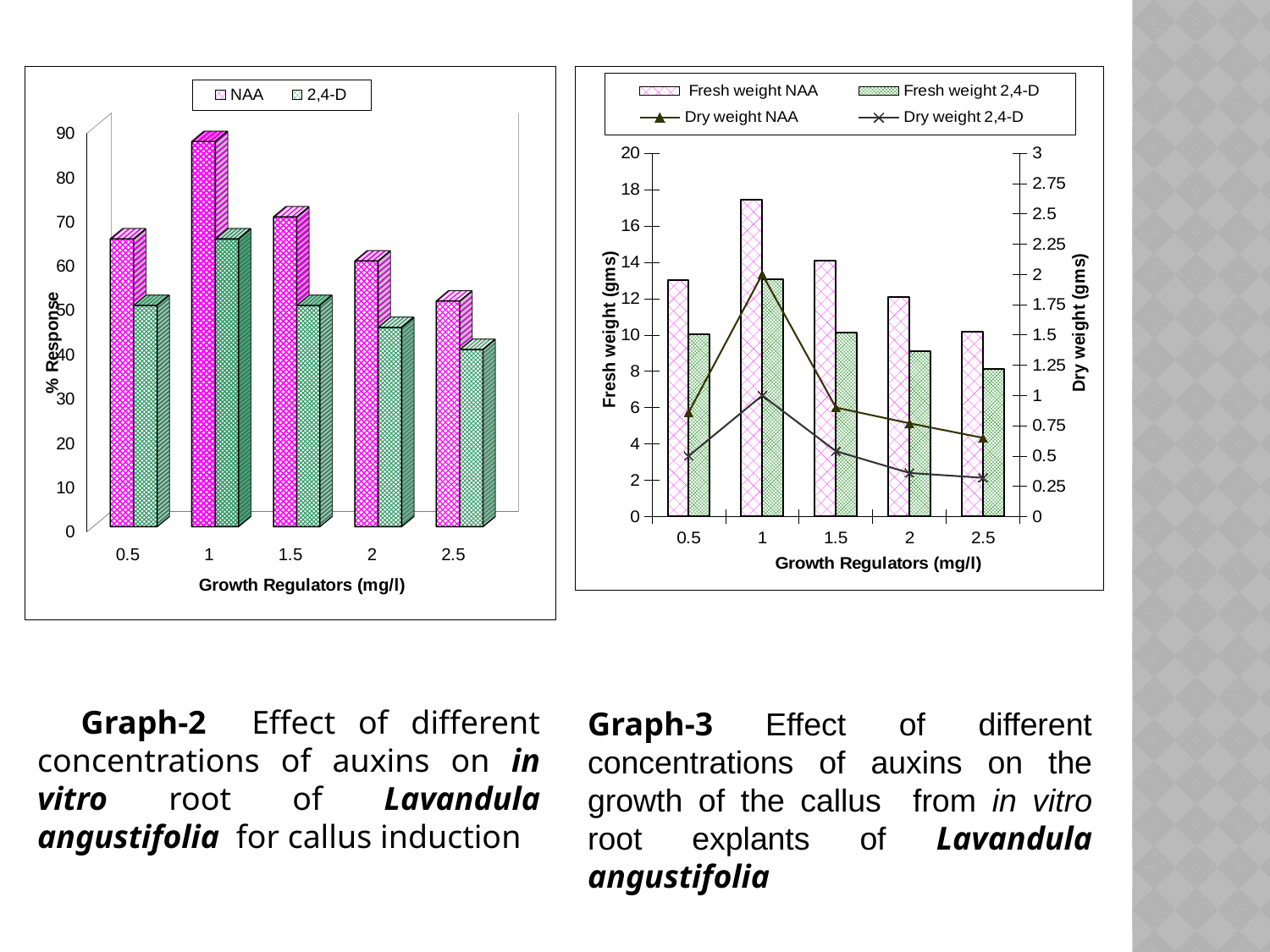
How many series does the legend of Graph-3 (right chart) list? 4 In Graph-2 (left chart), at which concentration is the 2,4-D bar lowest? 2.5 How many growth regulator concentrations are shown on the x axis of Graph-2 (left chart)? 5 What kind of chart is Graph-2 (left chart)? bar chart In Graph-2 (left chart), is the % Response for NAA at 1 mg/l greater or less than 80? greater In Graph-3 (right chart), at which concentration is the Fresh weight NAA bar highest? 1 In Graph-2 (left chart), at which growth regulator concentration is the NAA bar highest? 1 In Graph-3 (right chart), is the Fresh weight NAA value at 1 mg/l greater or less than 16? greater In Graph-2 (left chart), is the % Response for 2,4-D at 2.5 mg/l greater or less than 50? less In Graph-2 (left chart), which is larger at 1.5 mg/l, the NAA bar or the 2,4-D bar? NAA In Graph-3 (right chart), does the Fresh weight NAA series rise or fall from 1 mg/l to 2.5 mg/l? fall How many series does the legend of Graph-2 (left chart) list? 2